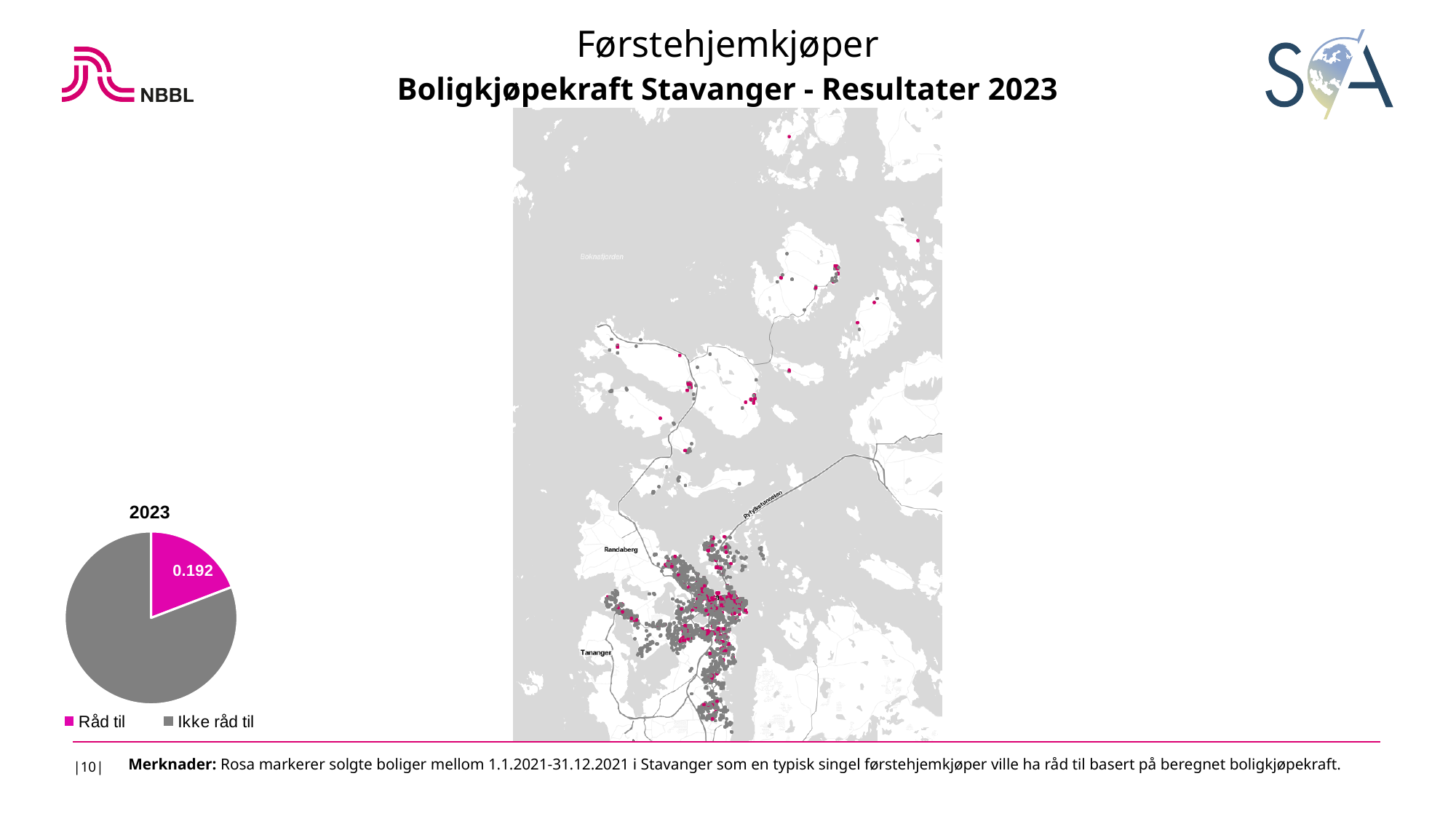
In the 2023 pie chart, which category has the smallest slice? Råd til In the 2023 pie chart, what value is shown for the Råd til slice? 0.192 In the 2023 pie chart, which category has the largest slice? Ikke råd til What share of the 2023 pie chart does the Råd til slice represent, as labelled? 0.192 What is the title shown above the pie chart? 2023 What kind of chart is shown on the left of the slide under the heading 2023? pie chart In the 2023 pie chart, which is larger: Råd til or Ikke råd til? Ikke råd til How many entries does the legend of the 2023 pie chart list? 2 What colour is the Råd til slice in the 2023 pie chart? pink How many slices does the 2023 pie chart have? 2